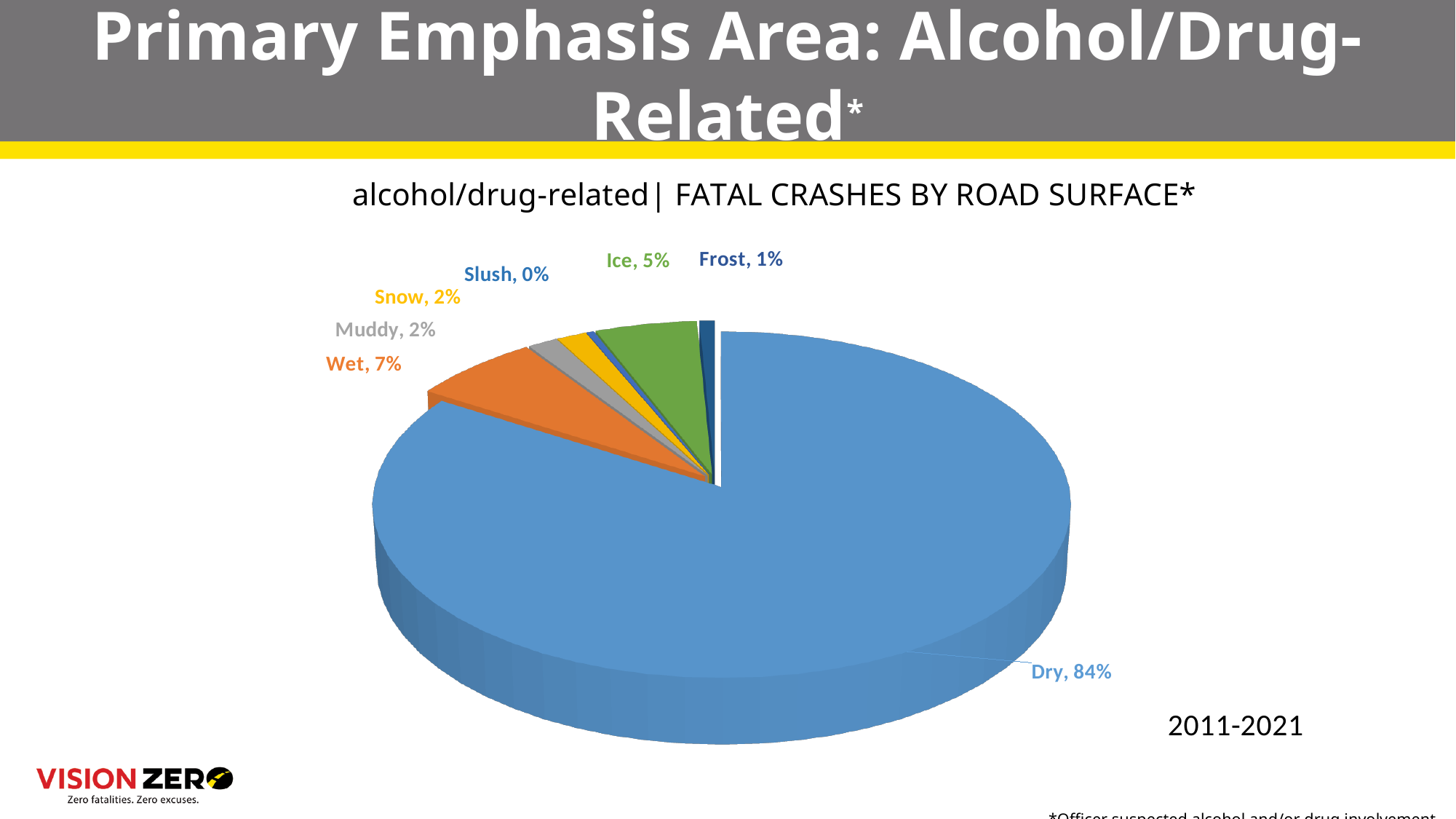
Which slice is larger, Ice or Wet? Wet How many road surface categories are shown in the pie chart? 7 What percentage is shown for the Frost slice? 1% What percentage is shown for the Ice slice? 5% What is the difference in percentage points between the Dry and Wet slices? 77 What type of chart is shown on the slide? Pie chart Which road surface category has the largest share of the pie? Dry What time period does the chart cover, as shown on the slide? 2011-2021 Which road surface category has the smallest share of the pie? Slush What percentage is shown for the Slush slice? 0% What share of alcohol/drug-related fatal crashes occurred on a wet road surface? 7% What share of alcohol/drug-related fatal crashes occurred on a dry road surface? 84%